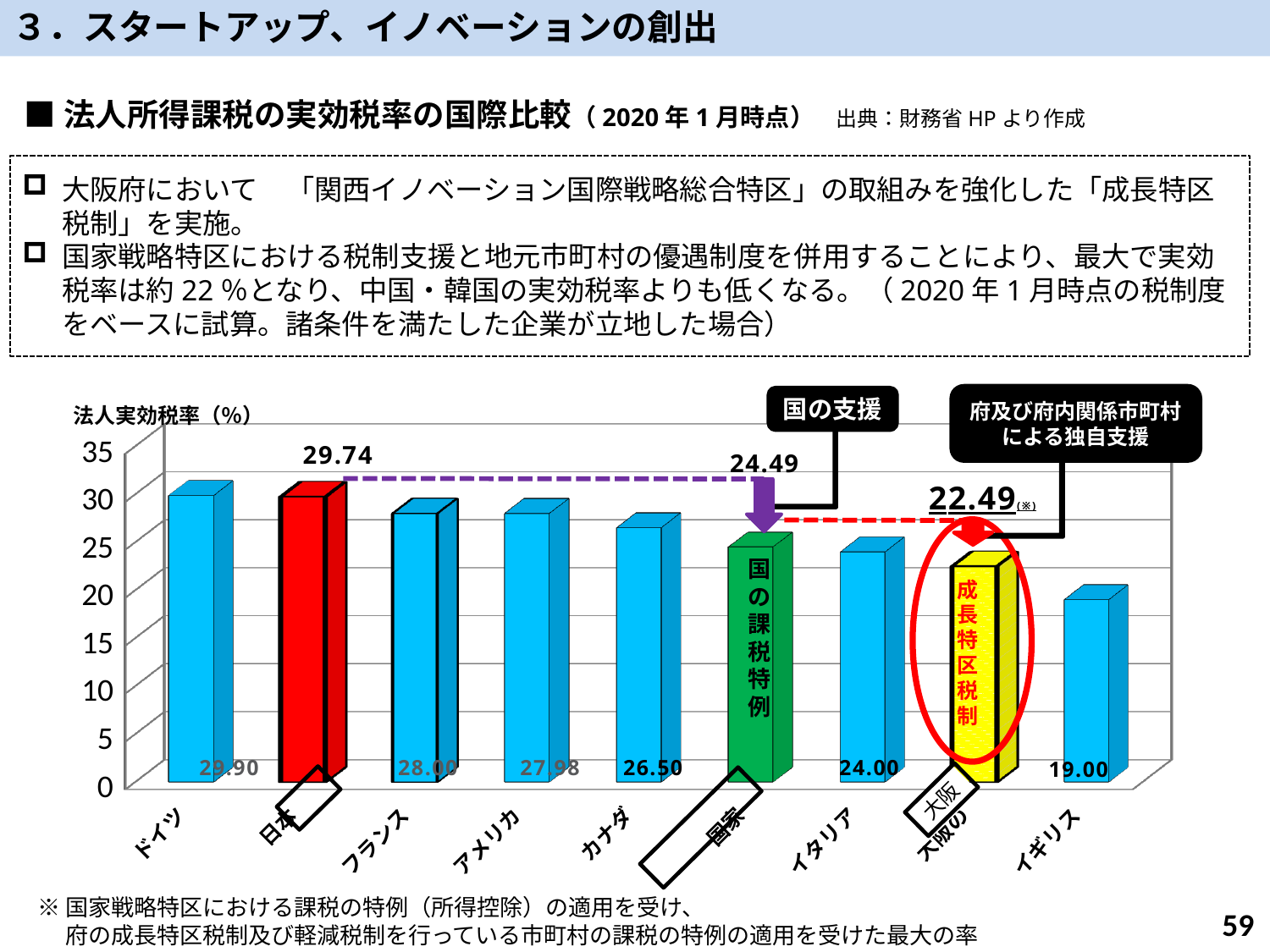
How many bars (countries/categories) are plotted in the chart? 9 Is the value for アメリカ greater or less than 25? greater What is the value shown for the green bar (国の課税特例) in the chart? 24.49 What is the difference between the value for 日本 (29.74) and the yellow 大阪 bar (22.49)? 7.25 What is the value shown for the yellow bar (大阪の成長特区税制) in the chart? 22.49 What type of chart is shown on the slide? Bar chart What is the difference between the green 国家 bar (24.49) and the yellow 大阪 bar (22.49)? 2.00 What is the label on the vertical axis of the chart? 法人実効税率（%） Which is larger, the value for カナダ or the value for イタリア? カナダ Which category has the lowest value in the chart? イギリス What is the value shown for カナダ (Canada) in the chart? 26.50 What is the value shown for 日本 (Japan) in the chart? 29.74